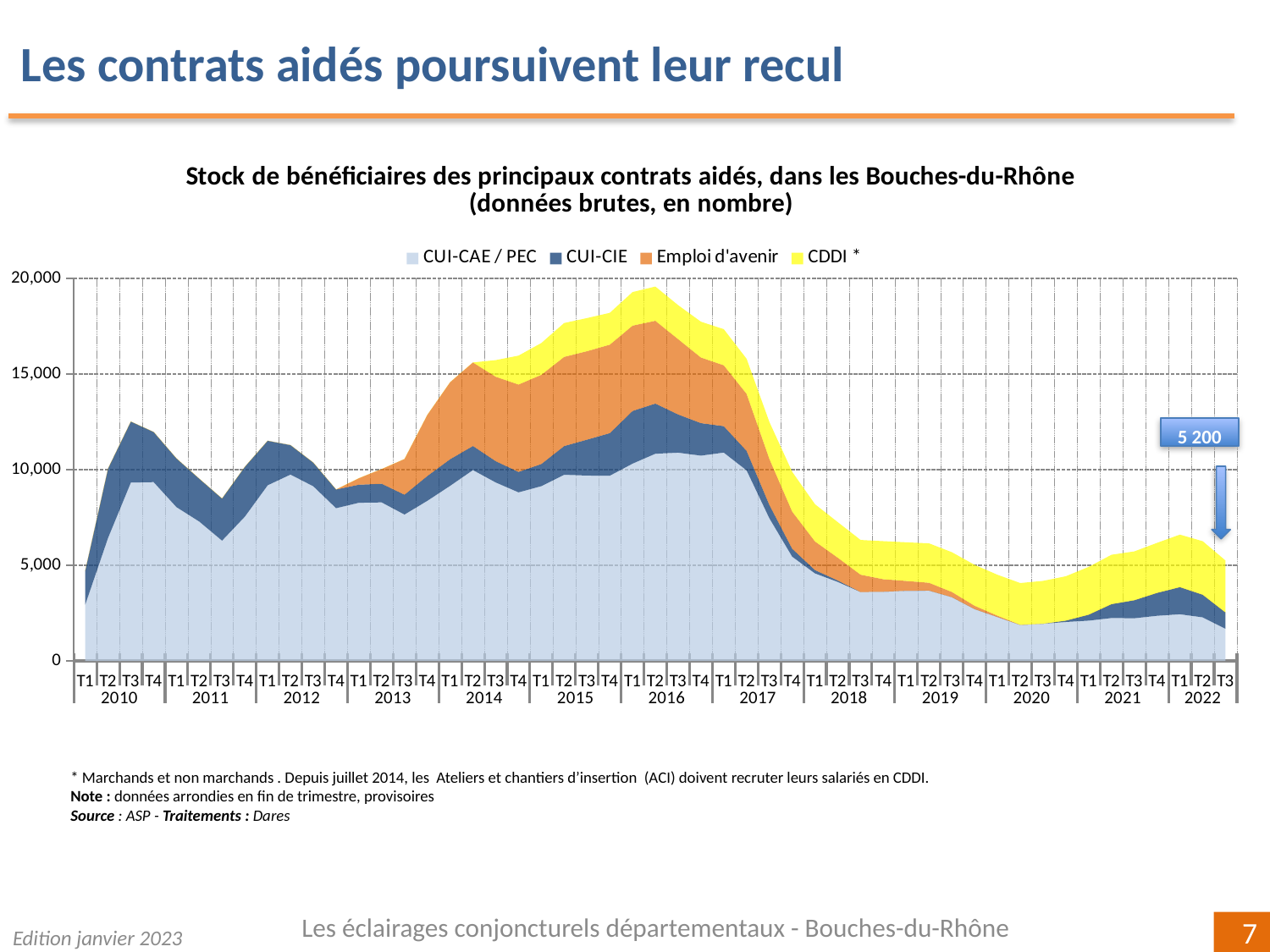
How many series does the legend list? 4 Is the total stock of beneficiaries in T1 2010 greater or less than 5,000? less What kind of chart is shown on the slide? Stacked area chart How many years are labelled along the x axis? 13 Is the total stock of beneficiaries in T2 2016 greater or less than 15,000? greater Does the total stock of beneficiaries rise or fall between 2016 and 2020? Fall What is the highest value shown on the y axis? 20,000 In T2 2016, which series is larger: CUI-CAE / PEC or CDDI? CUI-CAE / PEC What is the total stock of beneficiaries indicated by the callout for the last point (T3 2022)? 5 200 In which year does the total stock of beneficiaries reach its highest level? 2016 Is the total stock of beneficiaries in T2 2020 greater or less than 5,000? less Which series is shown in yellow? CDDI *